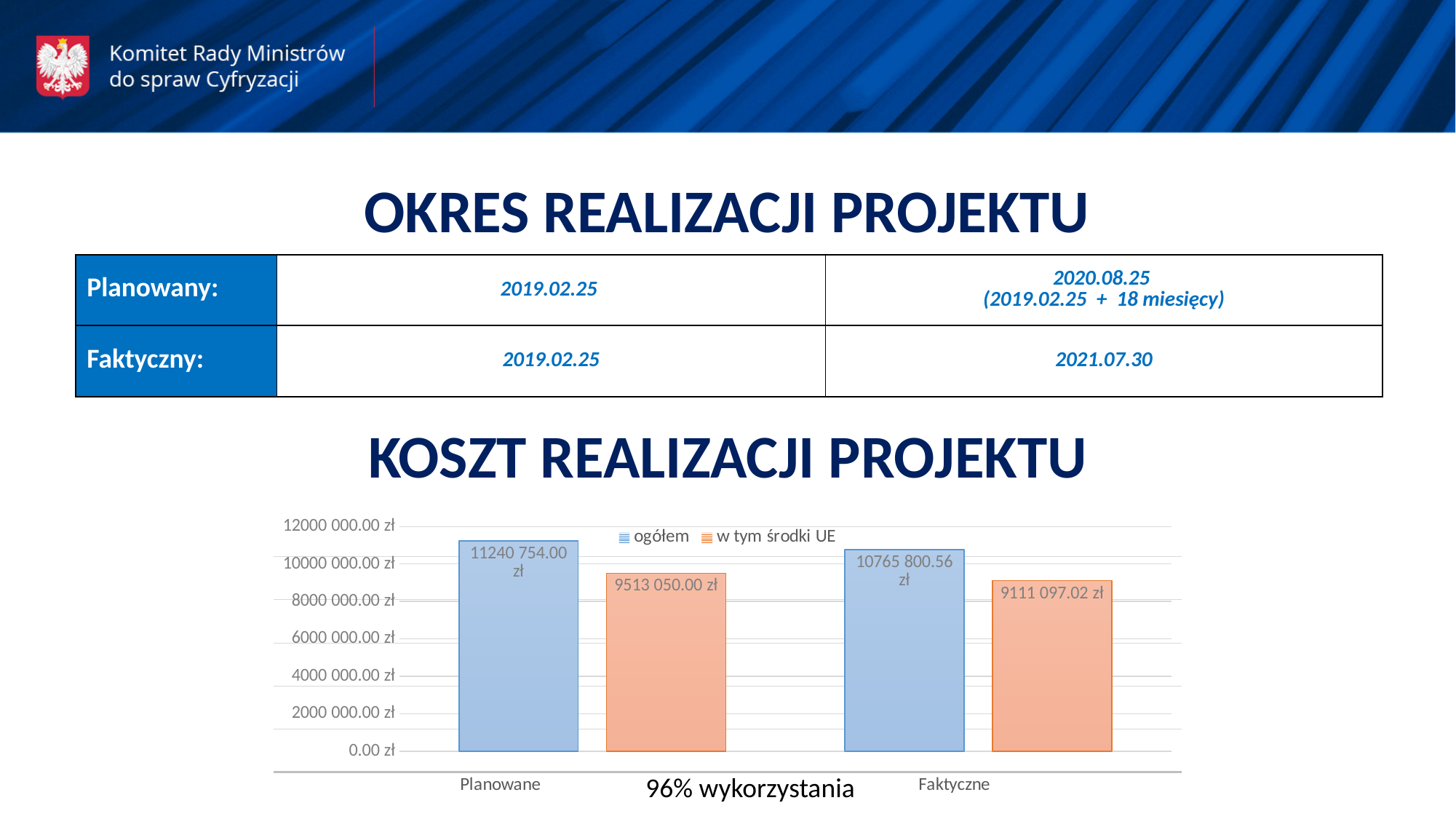
How many categories are shown on the x axis of the KOSZT REALIZACJI PROJEKTU chart? 2 In the KOSZT REALIZACJI PROJEKTU chart, what is the difference between the ogółem values for Planowane and Faktyczne? 474 953.44 zł How many series does the legend of the KOSZT REALIZACJI PROJEKTU chart list? 2 In the KOSZT REALIZACJI PROJEKTU chart, what is the value of ogółem for Faktyczne? 10765 800.56 zł In the KOSZT REALIZACJI PROJEKTU chart, which category has the higher ogółem value, Planowane or Faktyczne? Planowane In the KOSZT REALIZACJI PROJEKTU chart, which series is shown in orange? w tym środki UE In the KOSZT REALIZACJI PROJEKTU chart, what is the difference between ogółem and w tym środki UE for Faktyczne? 1654 703.54 zł In the KOSZT REALIZACJI PROJEKTU chart, what is the value of w tym środki UE for Planowane? 9513 050.00 zł In the KOSZT REALIZACJI PROJEKTU chart, what is the value of w tym środki UE for Faktyczne? 9111 097.02 zł In the KOSZT REALIZACJI PROJEKTU chart, what is the value of ogółem for Planowane? 11240 754.00 zł What type of chart is shown under the title KOSZT REALIZACJI PROJEKTU? bar chart In the KOSZT REALIZACJI PROJEKTU chart, is the w tym środki UE value for Faktyczne greater or less than 10000 000.00 zł? less